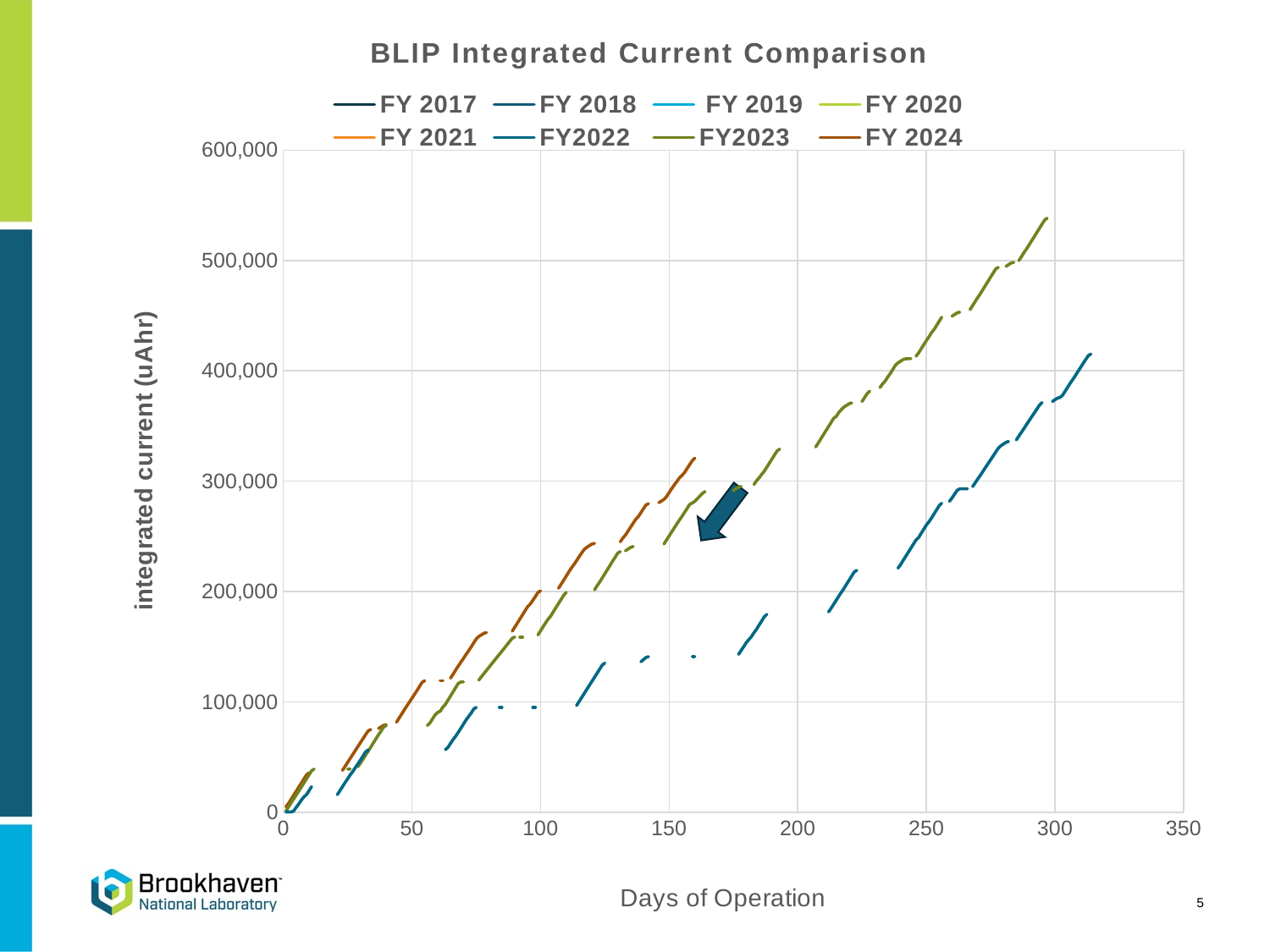
What is the label of the y axis? integrated current (uAhr) At 150 days of operation, which line is higher: FY 2024 or FY2023? FY 2024 Is the value of the FY2022 line at 200 days of operation greater or less than 200,000? less Is the final value of the FY 2024 line greater or less than 300,000? greater Which series reaches the highest integrated current on the chart? FY2023 What is the title of the chart? BLIP Integrated Current Comparison At 250 days of operation, which line is higher: FY2023 or FY2022? FY2023 How many series does the legend list? 8 What type of chart is shown on the slide? line chart Is the final value of the FY2023 line greater or less than 500,000? greater Do the integrated current values rise or fall as days of operation increase? rise